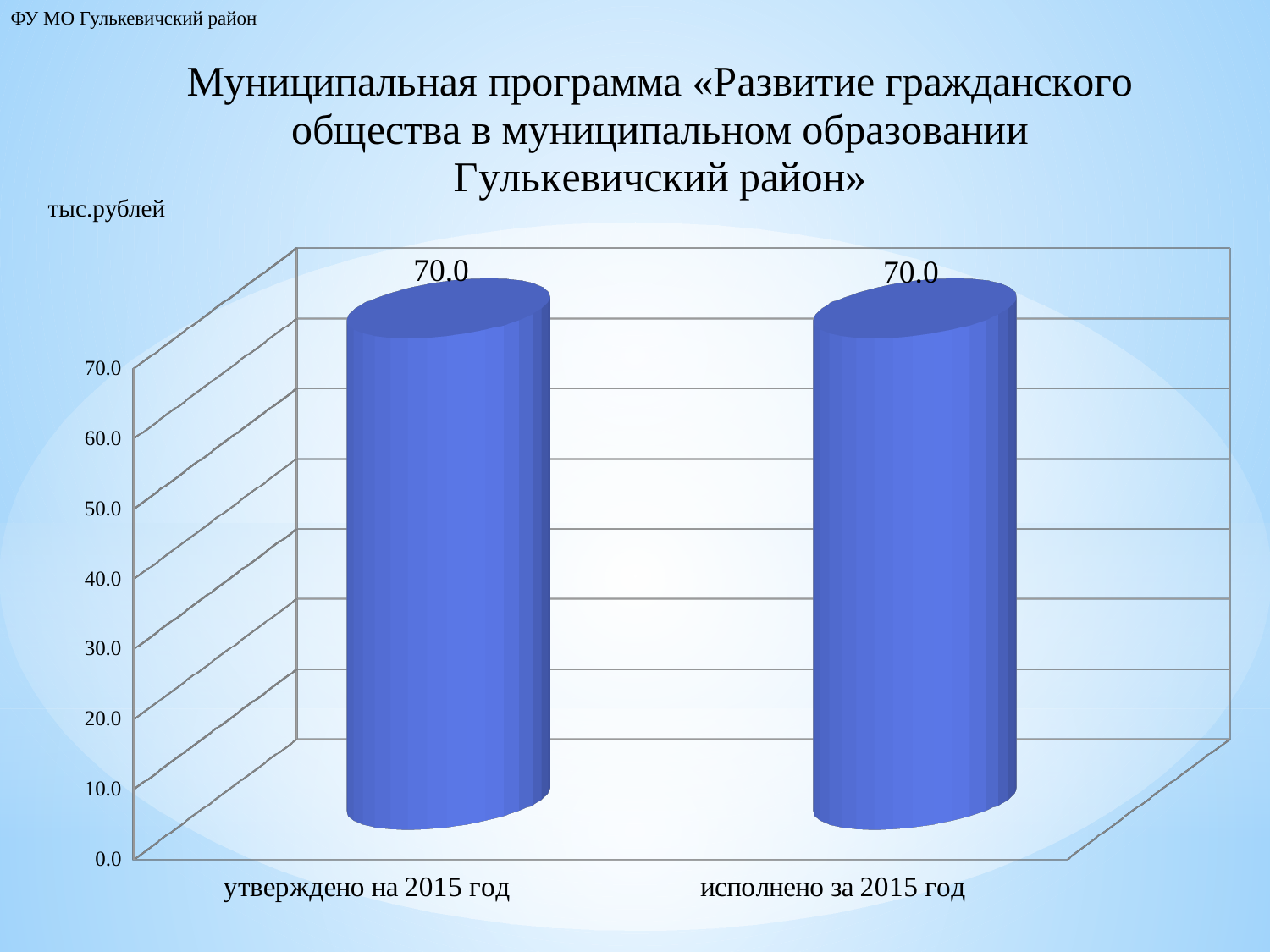
What is the difference between the values for «утверждено на 2015 год» and «исполнено за 2015 год»? 0.0 How many categories are shown on the chart? 2 Is the value for «утверждено на 2015 год» greater or less than 60.0? greater What is the value for «исполнено за 2015 год»? 70.0 Is the value for «исполнено за 2015 год» larger than, smaller than, or equal to the value for «утверждено на 2015 год»? equal Do the values rise, fall, or stay the same from «утверждено на 2015 год» to «исполнено за 2015 год»? stay the same What is the value for «утверждено на 2015 год»? 70.0 In what units are the values on the chart expressed? тыс.рублей What is the highest tick value shown on the vertical axis? 70.0 Is the value for «исполнено за 2015 год» greater or less than 50.0? greater What kind of chart is shown on the slide? bar chart